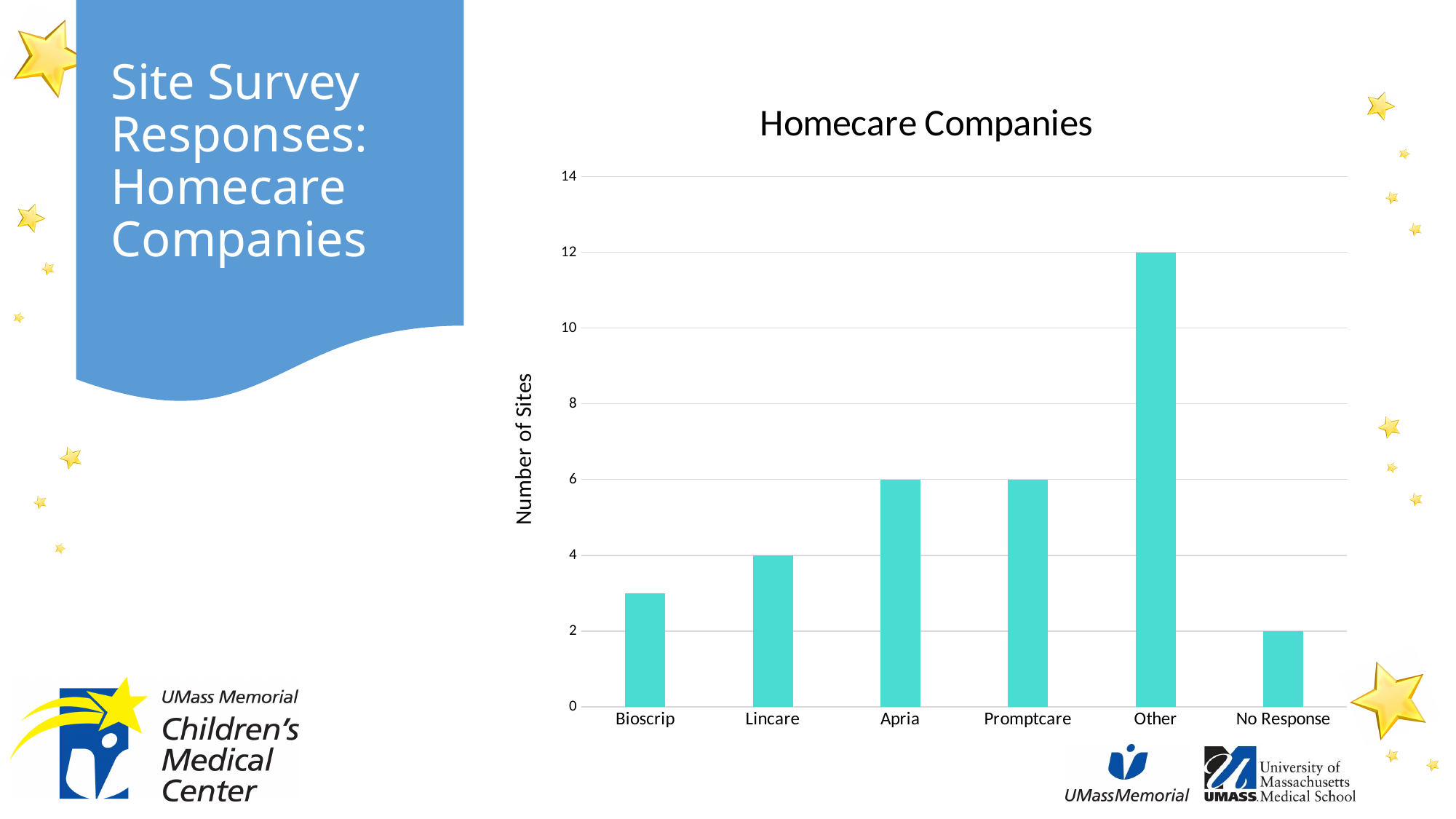
What is the difference in number of sites between Other and Lincare? 8 How many categories are shown on the x axis of the chart? 6 Which category has the highest number of sites? Other Is the value for Bioscrip greater or less than 4? less What kind of chart is shown on the slide? bar chart What is the number of sites for No Response? 2 What is the title of the chart? Homecare Companies What is the number of sites for Lincare? 4 What is the number of sites for Apria? 6 What is the label on the vertical axis of the chart? Number of Sites Which category has the lowest number of sites? No Response What is the number of sites for Other? 12